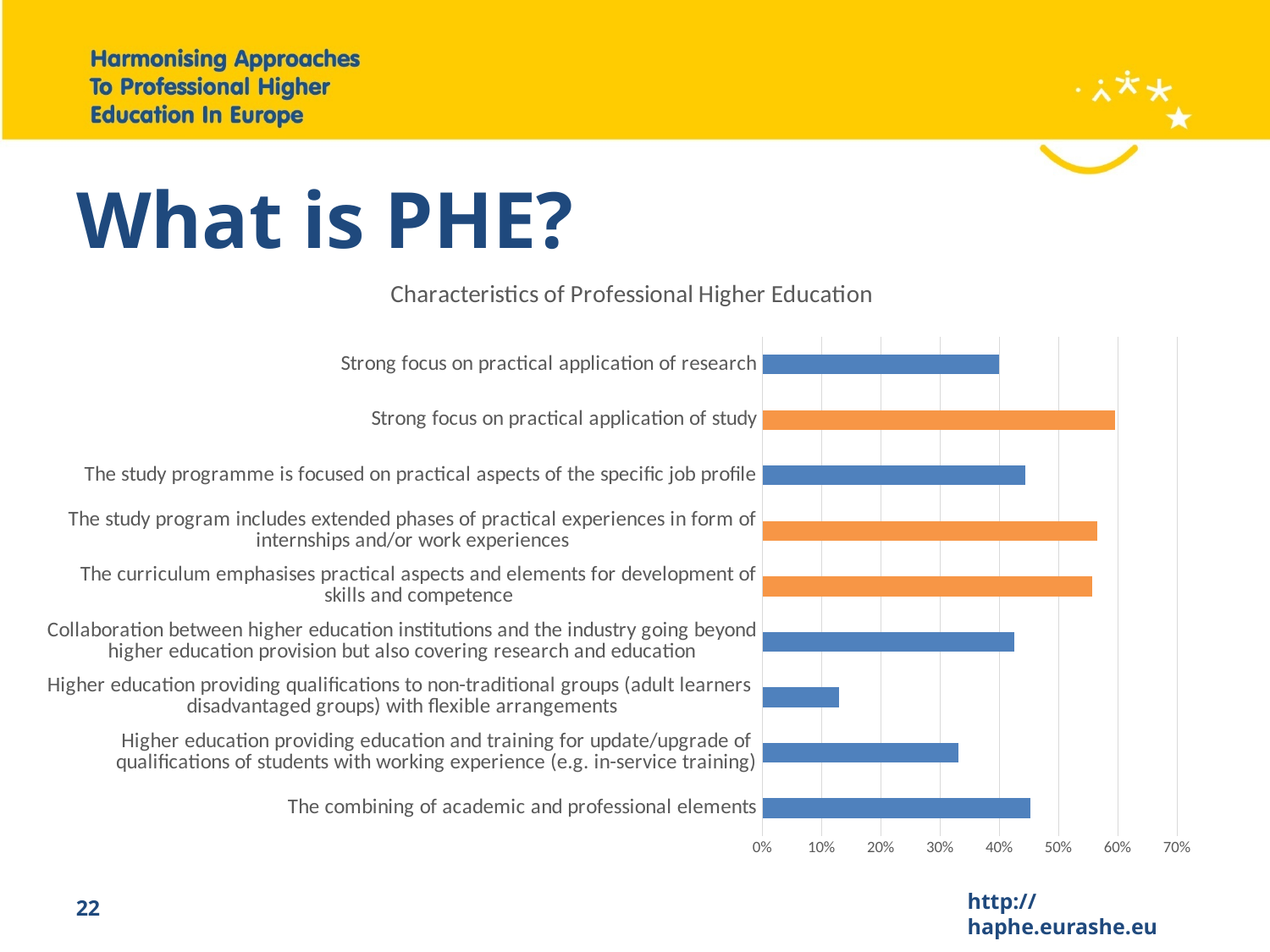
Is the value for 'Higher education providing qualifications to non-traditional groups (adult learners disadvantaged groups) with flexible arrangements' greater or less than 20%? less Which is larger: the value for 'Higher education providing education and training for update/upgrade of qualifications of students with working experience (e.g. in-service training)' or 'Higher education providing qualifications to non-traditional groups (adult learners disadvantaged groups) with flexible arrangements'? Higher education providing education and training for update/upgrade of qualifications of students with working experience (e.g. in-service training) What type of chart is shown on the slide? bar chart Which is larger: the value for 'Strong focus on practical application of study' or 'Strong focus on practical application of research'? Strong focus on practical application of study Which category has the lowest value? Higher education providing qualifications to non-traditional groups (adult learners disadvantaged groups) with flexible arrangements How many bars in the chart are coloured orange? 3 Is the value for 'The study program includes extended phases of practical experiences in form of internships and/or work experiences' greater or less than 50%? greater Is the value for 'Strong focus on practical application of study' greater or less than 50%? greater How many categories are plotted in the chart? 9 What is the title of the chart? Characteristics of Professional Higher Education Which category has the highest value? Strong focus on practical application of study